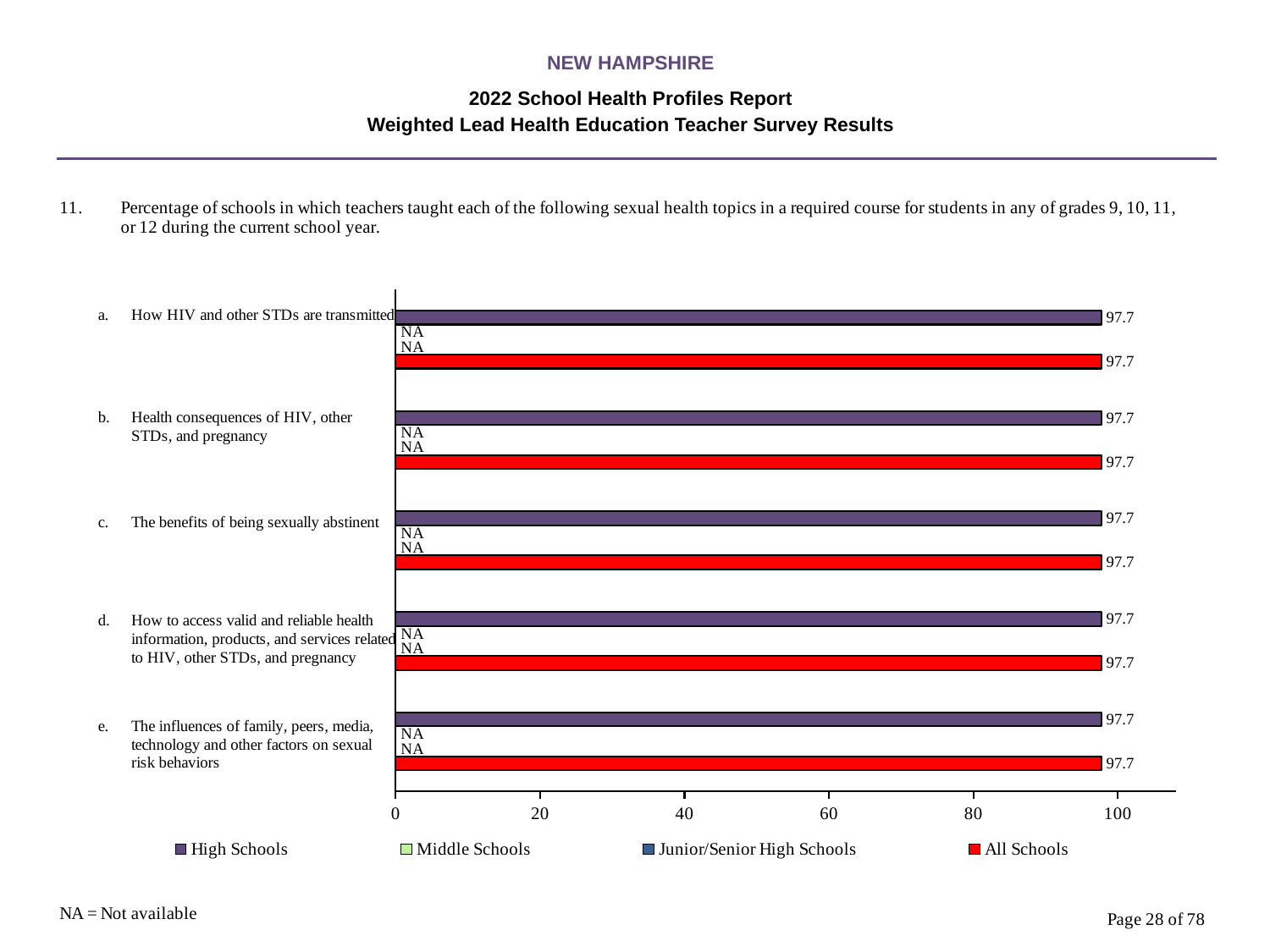
What does NA stand for according to the note on the slide? Not available What is the High Schools value for 'How HIV and other STDs are transmitted'? 97.7 What is the All Schools value for 'The benefits of being sexually abstinent'? 97.7 What kind of chart is shown on the slide? bar chart How many sexual health topics are listed on the chart? 5 How many series does the legend list? 4 What is the High Schools value for 'The influences of family, peers, media, technology and other factors on sexual risk behaviors'? 97.7 What is shown for Middle Schools for 'Health consequences of HIV, other STDs, and pregnancy'? NA What is the All Schools value for 'How to access valid and reliable health information, products, and services related to HIV, other STDs, and pregnancy'? 97.7 What is the difference between the High Schools and All Schools values for 'Health consequences of HIV, other STDs, and pregnancy'? 0 Which legend entry is shown in red? All Schools Is the High Schools value for 'The benefits of being sexually abstinent' greater or less than 80? greater